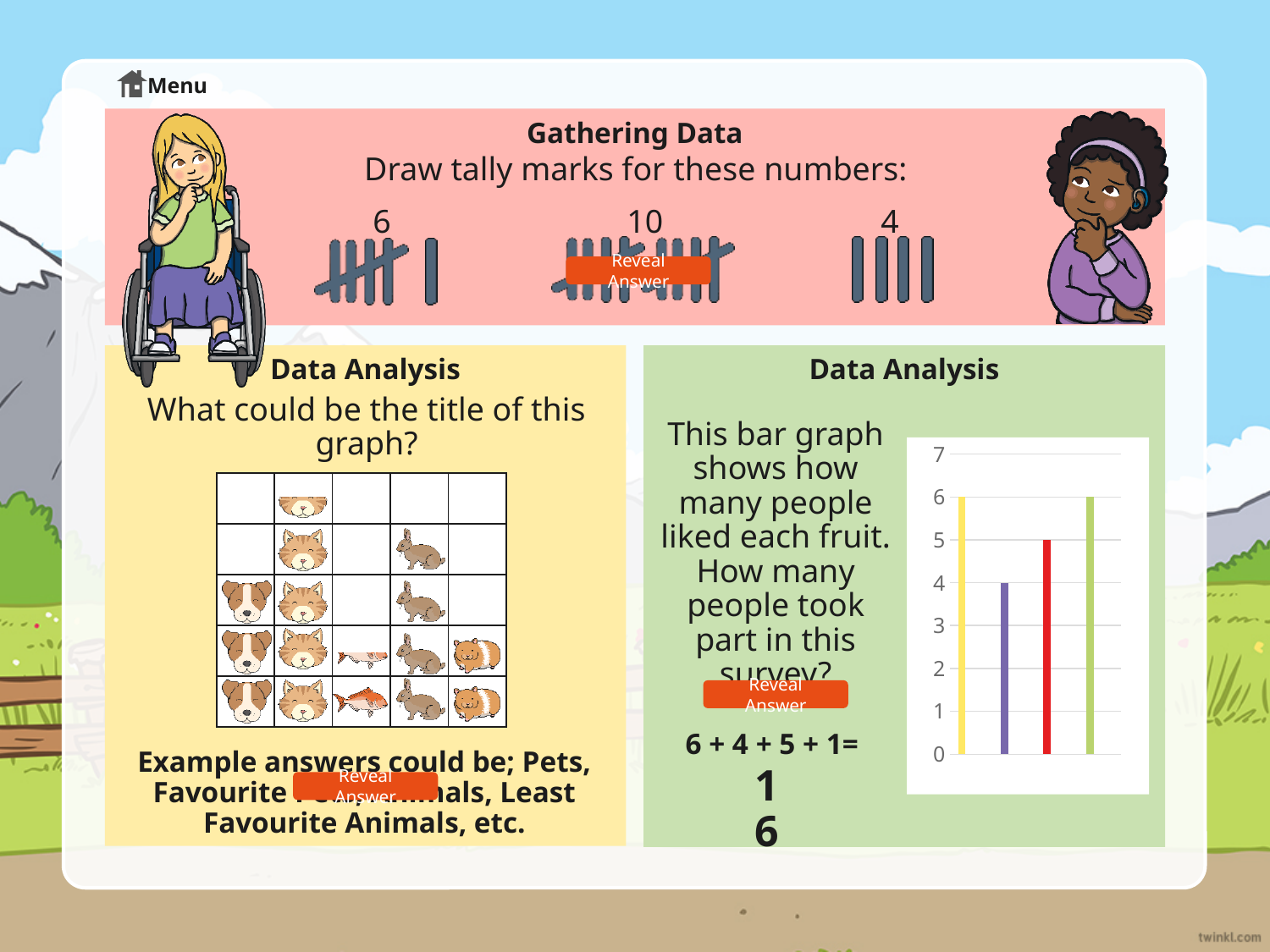
In the bar chart on the right, what value does the red bar reach? 5 In the bar chart on the right, which is taller, the red bar or the purple bar? red In the bar chart on the right, which coloured bar is the lowest? purple In the pictogram on the left, how many dog pictures are shown? 3 In the pictogram on the left, how many cat pictures are shown? 5 In the bar chart on the right, what value does the purple bar reach? 4 What kind of chart is shown in the right-hand Data Analysis panel? bar chart In the bar chart on the right, what value does the yellow bar reach? 6 In the bar chart on the right, what value does the green bar reach? 6 In the bar chart on the right, how many bars are plotted? 4 In the bar chart on the right, what is the difference between the yellow bar and the purple bar? 2 In the bar chart on the right, what is the highest value shown on the vertical axis? 7